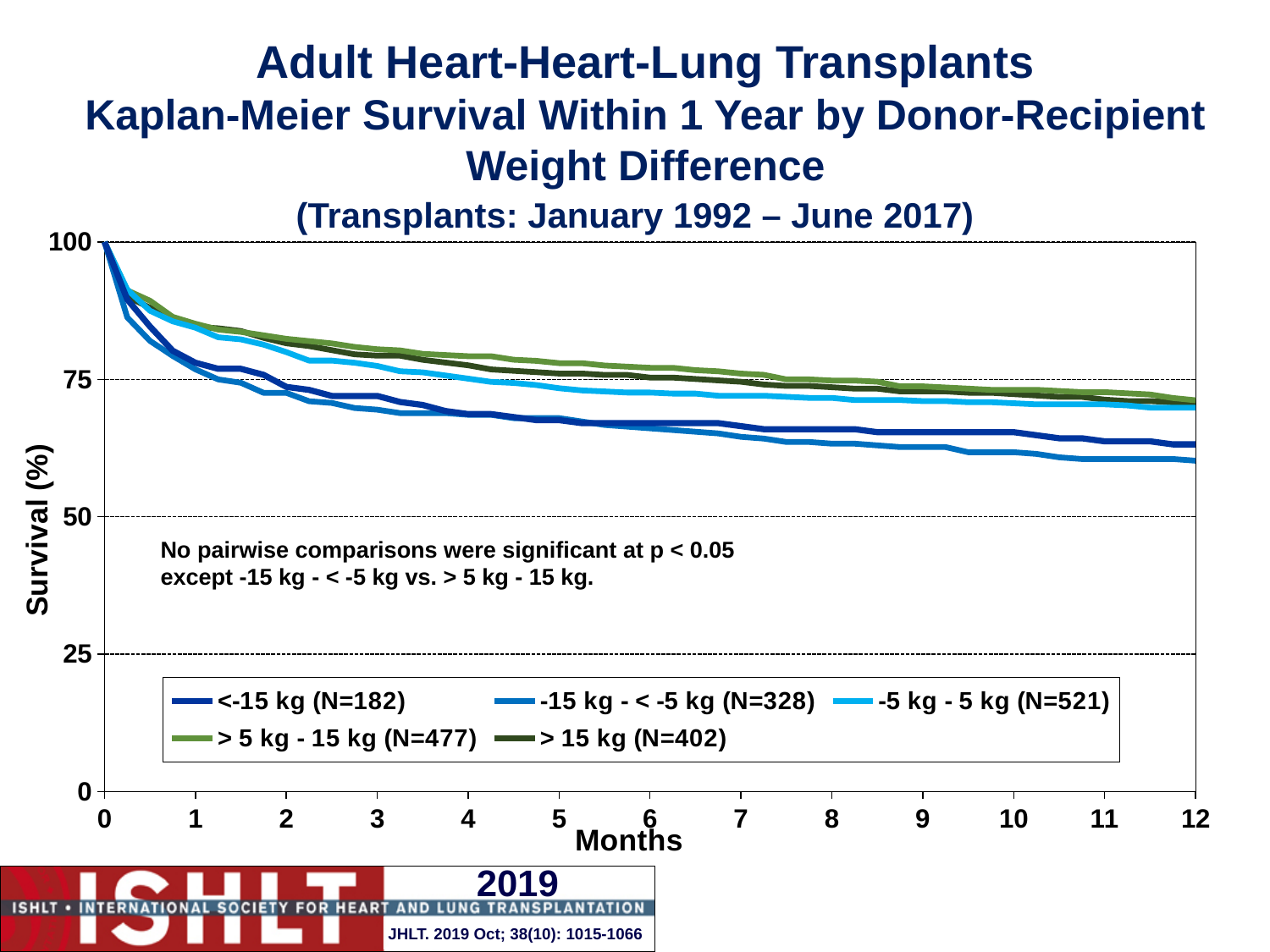
What is the label of the y axis? Survival (%) At 12 months, is the survival for the > 5 kg - 15 kg group greater or less than 75? less What kind of chart is shown on the slide? Line chart At 12 months, which group has higher survival: > 5 kg - 15 kg or <-15 kg? > 5 kg - 15 kg How many series does the legend list? 5 At 12 months, is the survival for the <-15 kg group greater or less than 75? less At 12 months, is the survival for the -15 kg - < -5 kg group greater or less than 50? greater What is the maximum value shown on the x axis (Months)? 12 What is the N for the -5 kg - 5 kg group shown in the legend? 521 Do the survival curves rise or fall as months increase? Fall At 12 months, which group has higher survival: -5 kg - 5 kg or -15 kg - < -5 kg? -5 kg - 5 kg